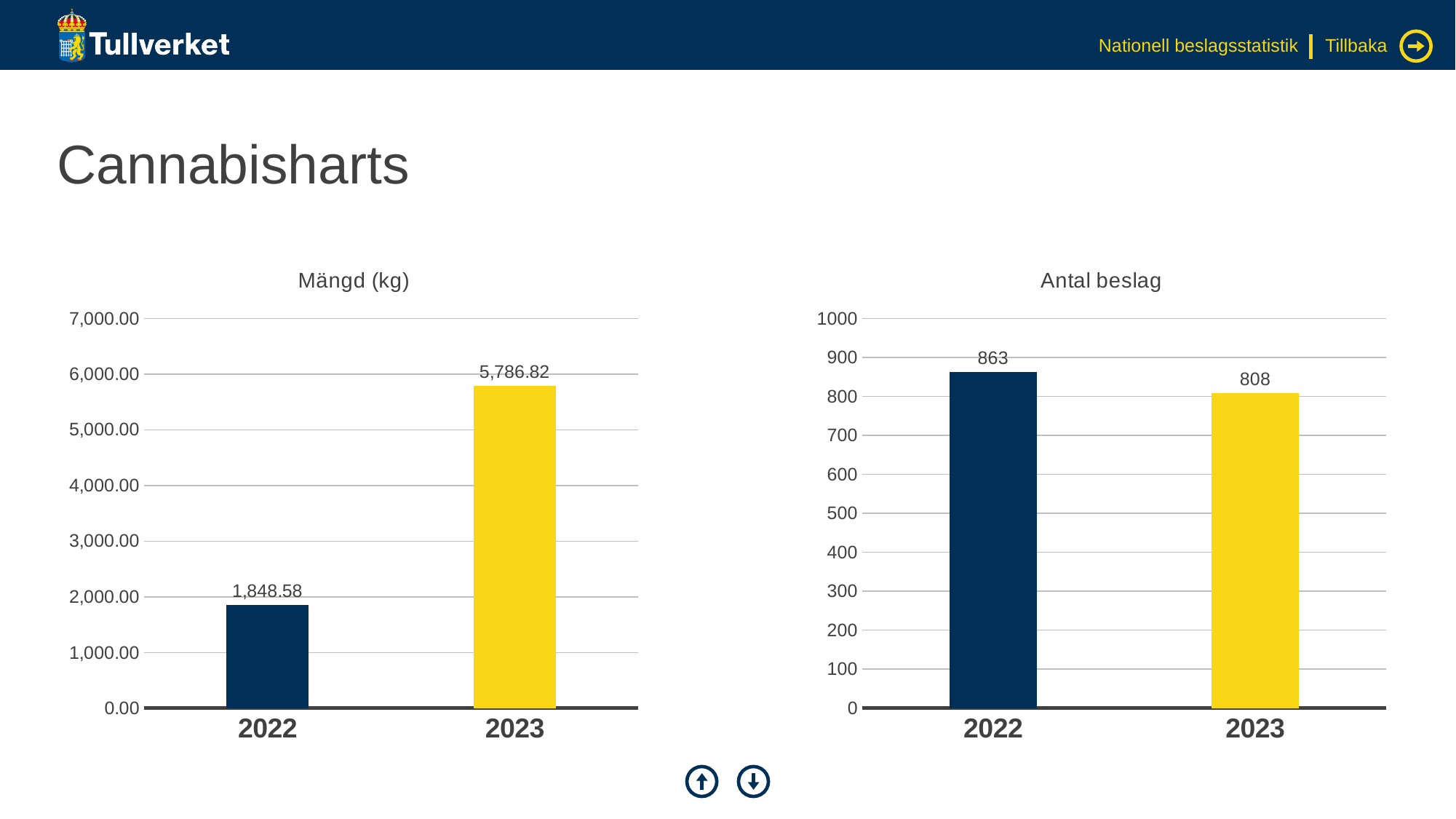
In the "Antal beslag" chart, which year has the lowest value? 2023 In the "Mängd (kg)" chart, what is the value for 2023? 5,786.82 In the "Mängd (kg)" chart, what is the difference between the 2023 and 2022 values? 3,938.24 In the "Antal beslag" chart, what is the difference between the 2022 and 2023 values? 55 In the "Mängd (kg)" chart, what is the value for 2022? 1,848.58 In the "Antal beslag" chart, what is the value for 2023? 808 In the "Antal beslag" chart, what is the value for 2022? 863 In the "Antal beslag" chart, is the value for 2022 larger or smaller than the value for 2023? larger In the "Mängd (kg)" chart, which year has the highest value? 2023 How many categories are shown on the x axis of the "Antal beslag" chart? 2 What kind of chart is the "Mängd (kg)" chart? bar chart In the "Mängd (kg)" chart, do the values rise or fall from 2022 to 2023? rise